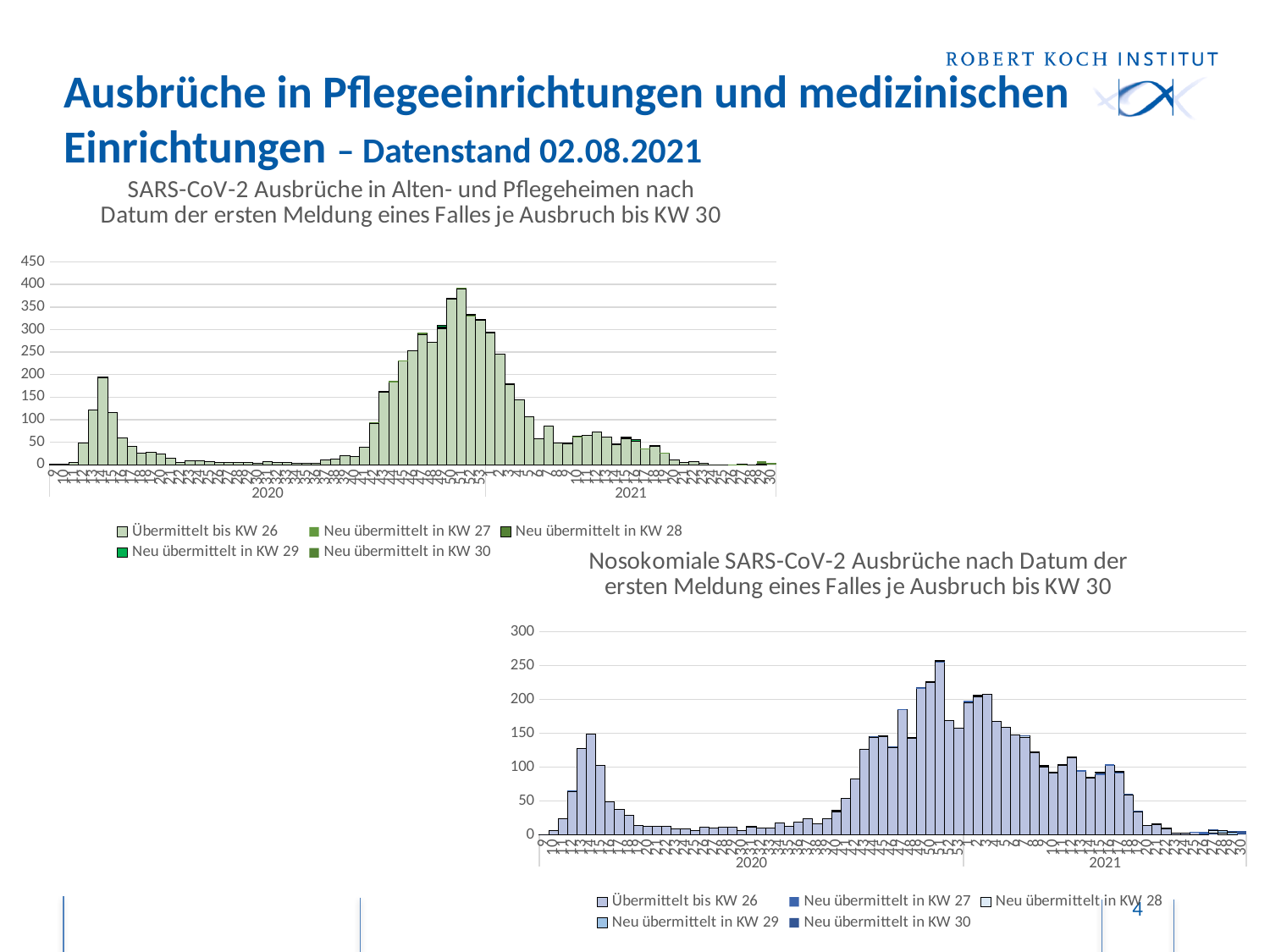
What kind of chart is the bottom chart titled 'Nosokomiale SARS-CoV-2 Ausbrüche'? Stacked bar chart Which chart has the higher peak bar, the top chart (Alten- und Pflegeheime) or the bottom chart (Nosokomiale Ausbrüche)? The top chart In the bottom chart, is the value of the highest bar greater or less than 200? greater In the bottom chart, is the value of the highest bar in the spring 2020 wave greater or less than 200? less In the top chart, in which year does the highest bar occur? 2020 What is the first legend entry of the bottom chart? Übermittelt bis KW 26 How many series does the legend of the bottom chart list? 5 How many series does the legend of the top chart list? 5 In the top chart, is the value of the highest bar in the spring 2020 wave greater or less than 250? less In the top chart, do the values rise or fall from the peak at the end of 2020 through the weeks of 2021? fall What kind of chart is the top chart titled 'SARS-CoV-2 Ausbrüche in Alten- und Pflegeheimen'? Stacked bar chart